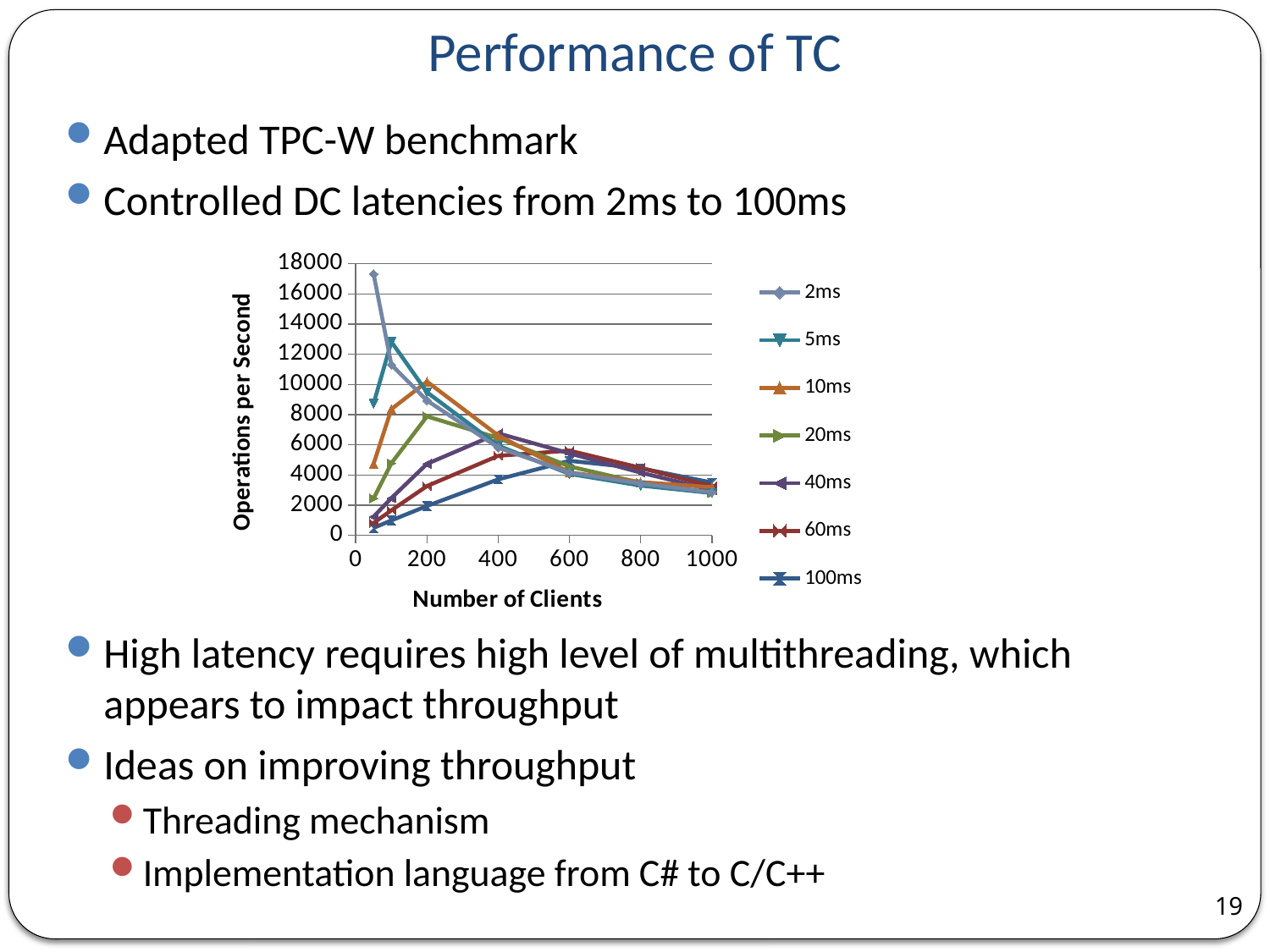
Is the value for the 2ms series at its first point (about 50 clients) greater or less than 16000? greater At 100 clients, which series has the higher operations per second: 5ms or 10ms? 5ms How many series does the chart legend list? 7 What is the title of the chart's x axis? Number of Clients Does the 2ms series rise or fall as the number of clients increases? fall What is the highest tick value shown on the y axis? 18000 Which latency series reaches the highest operations per second anywhere on the chart? 2ms Which latency series has the lowest operations per second at the smallest number of clients? 100ms Is the value for the 40ms series at 200 clients greater or less than 6000? less What is the title of the chart's y axis? Operations per Second Is the value for the 5ms series at 100 clients greater or less than 12000? greater What kind of chart is shown on the slide? line chart